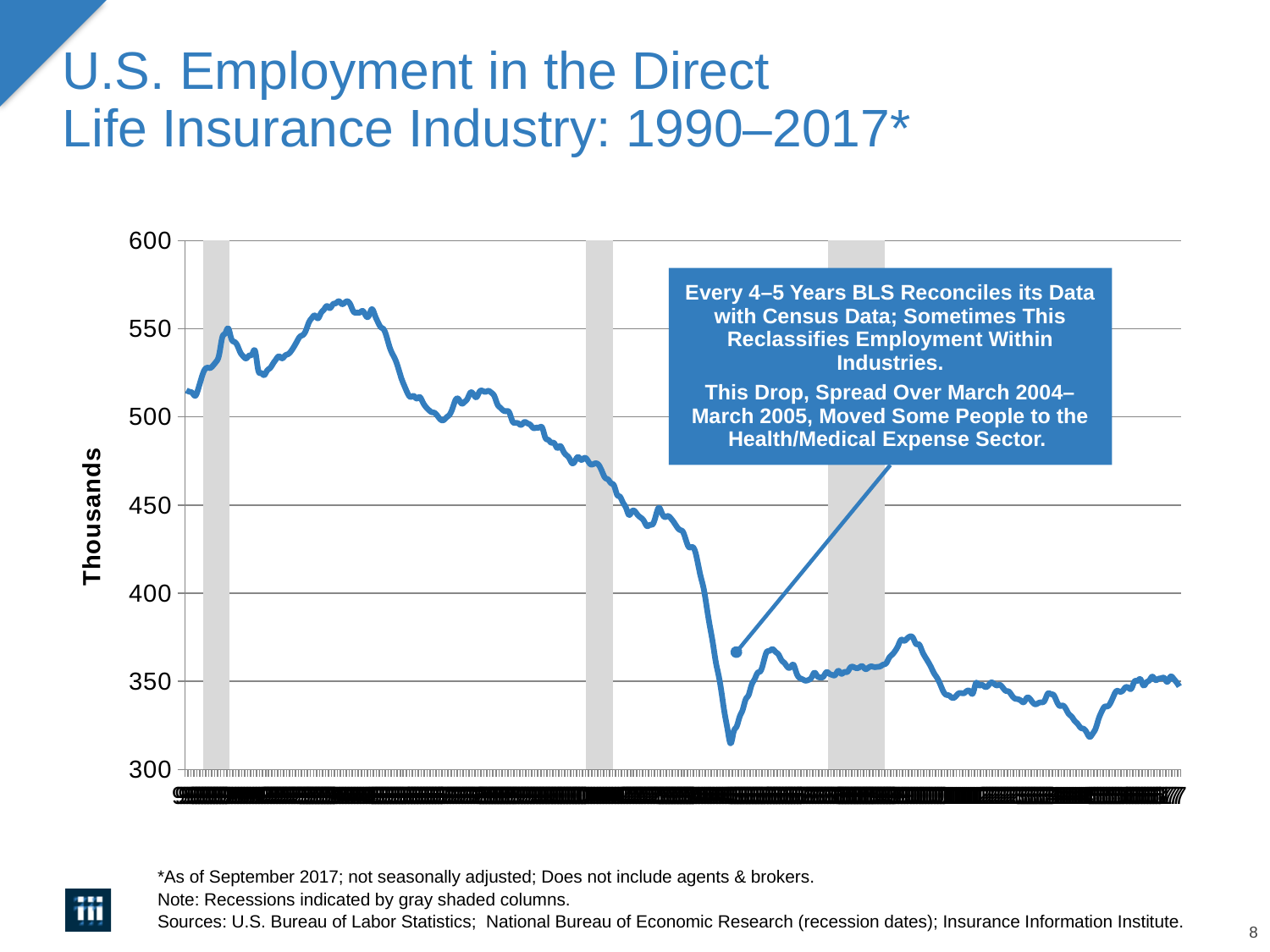
Is the value at the left-hand end of the employment line greater or less than 500? greater Is the lowest point reached by the employment line greater or less than 350? less What kind of chart is shown on the slide? line chart Is the highest point reached by the employment line greater or less than 550? greater What is the label on the vertical axis of the chart? Thousands Overall, does the employment line rise or fall from the left of the chart to the right? fall How many gray shaded recession columns are shown on the chart? 3 Which is larger, the value at the start of the line (left end) or the value at the end of the line (right end)? the start (left end) What is the title of the chart? U.S. Employment in the Direct Life Insurance Industry: 1990–2017* What is the lowest value shown on the vertical axis? 300